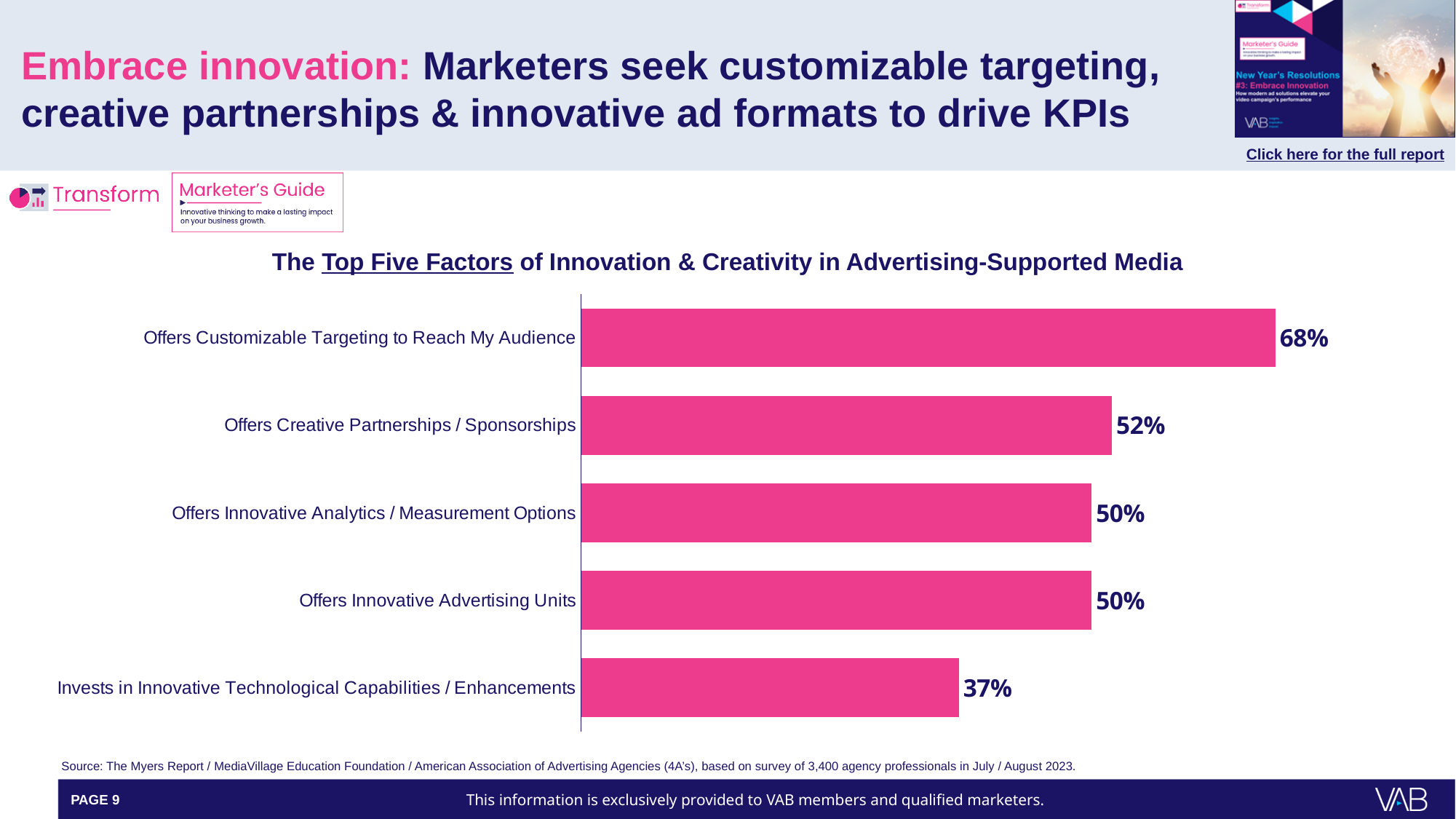
What value is shown for "Offers Creative Partnerships / Sponsorships"? 52% Which factor has the lowest percentage? Invests in Innovative Technological Capabilities / Enhancements Which is larger: the value for "Offers Creative Partnerships / Sponsorships" or for "Invests in Innovative Technological Capabilities / Enhancements"? Offers Creative Partnerships / Sponsorships What value is shown for "Offers Innovative Advertising Units"? 50% Which factor has the highest percentage? Offers Customizable Targeting to Reach My Audience What is the title of the chart? The Top Five Factors of Innovation & Creativity in Advertising-Supported Media What type of chart is shown on the slide? Bar chart What percentage is shown for "Offers Customizable Targeting to Reach My Audience"? 68% How many factors are shown in the chart? 5 What is the difference in percentage points between "Offers Customizable Targeting to Reach My Audience" and "Offers Creative Partnerships / Sponsorships"? 16 percentage points What percentage is shown for "Invests in Innovative Technological Capabilities / Enhancements"? 37% What is the difference between "Offers Innovative Analytics / Measurement Options" and "Invests in Innovative Technological Capabilities / Enhancements"? 13 percentage points